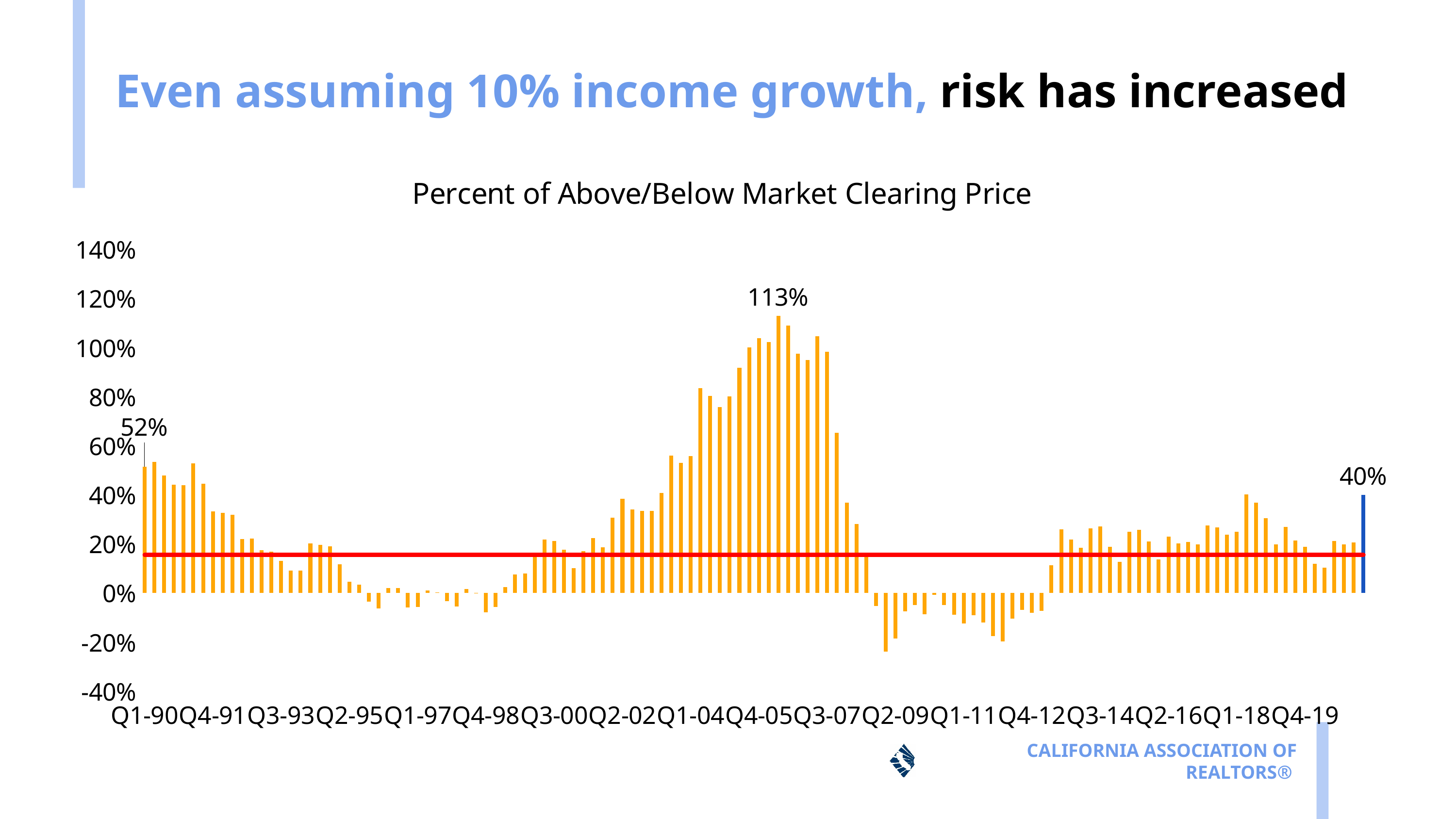
What is the title of the chart? Percent of Above/Below Market Clearing Price What is the highest value labeled on the chart? 113% What is the difference between the peak value of 113% and the final value of 40%? 73 percentage points What is the value of the last bar (Q4-19), shown in blue? 40% Which is larger, the value for Q1-90 or the value for Q4-19? Q1-90 What colour is the final bar (Q4-19) on the chart? blue Is the value for Q4-05 greater or less than 80%? greater What is the value of the first bar (Q1-90)? 52% Do the values rise or fall from Q1-90 to Q2-95? fall Is the value for Q2-09 greater or less than 0%? less What kind of chart is shown on the slide? combination bar and line chart